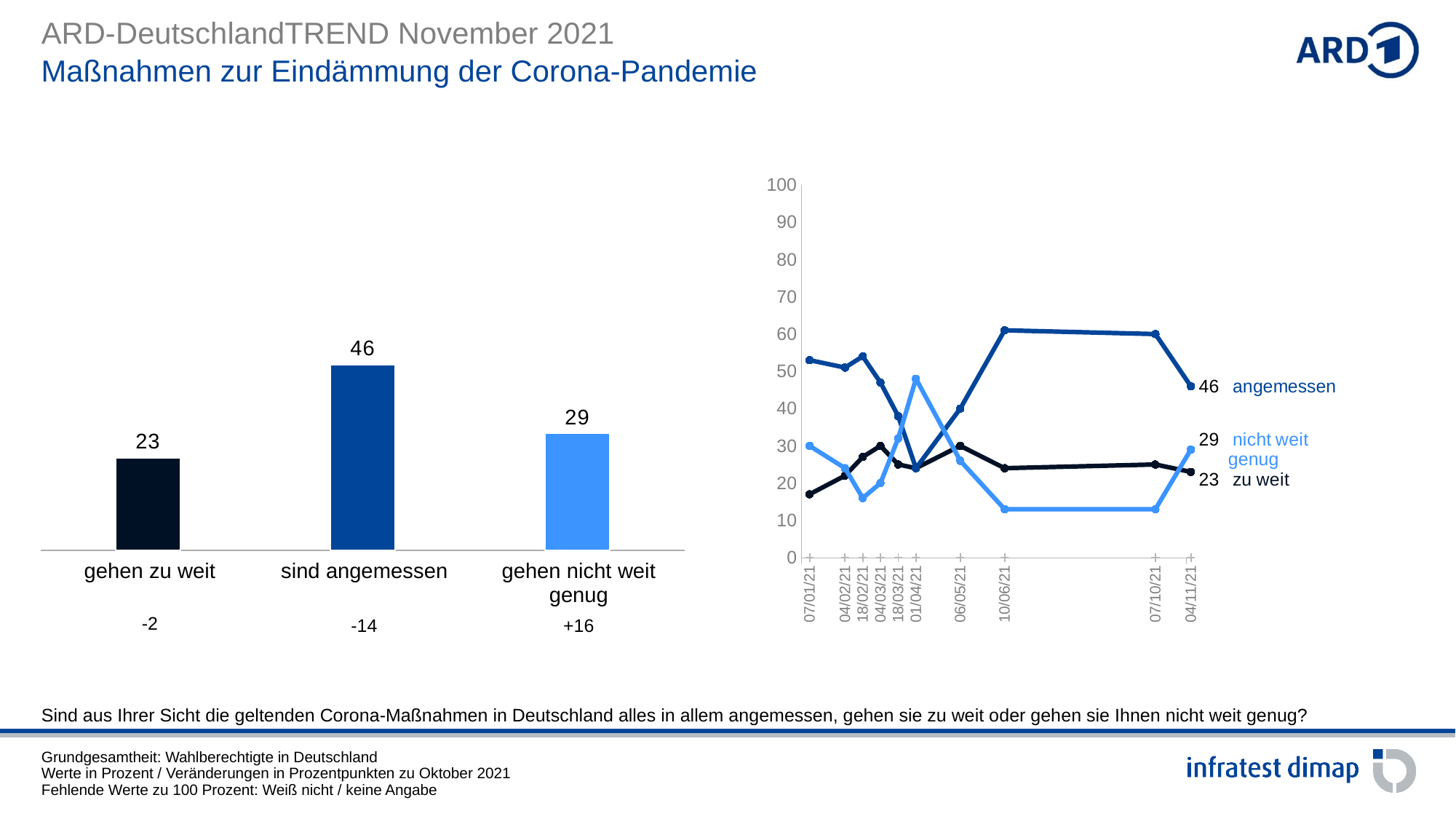
In the line chart on the right, how many series are plotted? 3 What kind of chart is the chart on the right of the slide? line chart In the line chart on the right, is the value of the "angemessen" line at 07/01/21 greater or less than 50? greater In the line chart on the right, is the value of the "nicht weit genug" line at 10/06/21 greater or less than 20? less In the bar chart on the left, what change in percentage points compared with October 2021 is shown under "gehen nicht weit genug"? +16 In the bar chart on the left, what is the value for "sind angemessen"? 46 In the bar chart on the left, what is the value for "gehen nicht weit genug"? 29 In the line chart on the right, how many dates are shown on the x axis? 10 In the line chart on the right, what is the value of the "angemessen" line at the last date, 04/11/21? 46 In the bar chart on the left, which category has the lowest value? gehen zu weit In the bar chart on the left, how many categories are shown? 3 In the bar chart on the left, what is the difference between the values for "sind angemessen" and "gehen zu weit"? 23